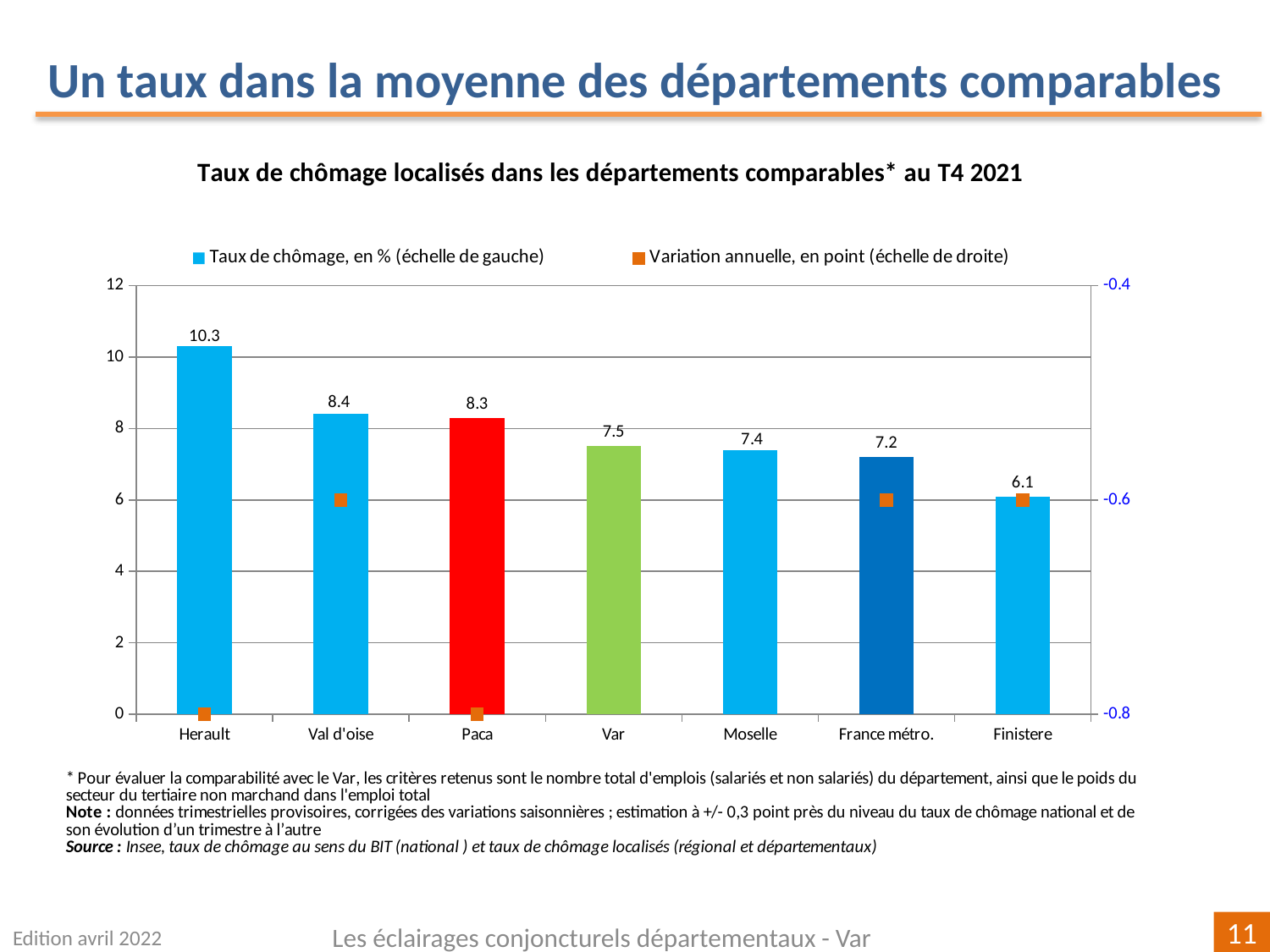
What is the unemployment rate (Taux de chômage, en %) shown for Herault? 10.3 What kind of chart is used to show the unemployment rates? Bar chart Which category has the lowest unemployment rate? Finistere How many categories are shown on the x axis of the chart? 7 What is the difference between the unemployment rates of Var and France métro.? 0.3 What is the difference between the unemployment rates of Herault and Finistere? 4.2 Which has a higher unemployment rate, Val d'oise or Paca? Val d'oise Which category has the highest unemployment rate? Herault How many series does the legend list? 2 What is the unemployment rate shown for France métro.? 7.2 What is the unemployment rate shown for Var? 7.5 Is the unemployment rate for Moselle greater or less than 8? less